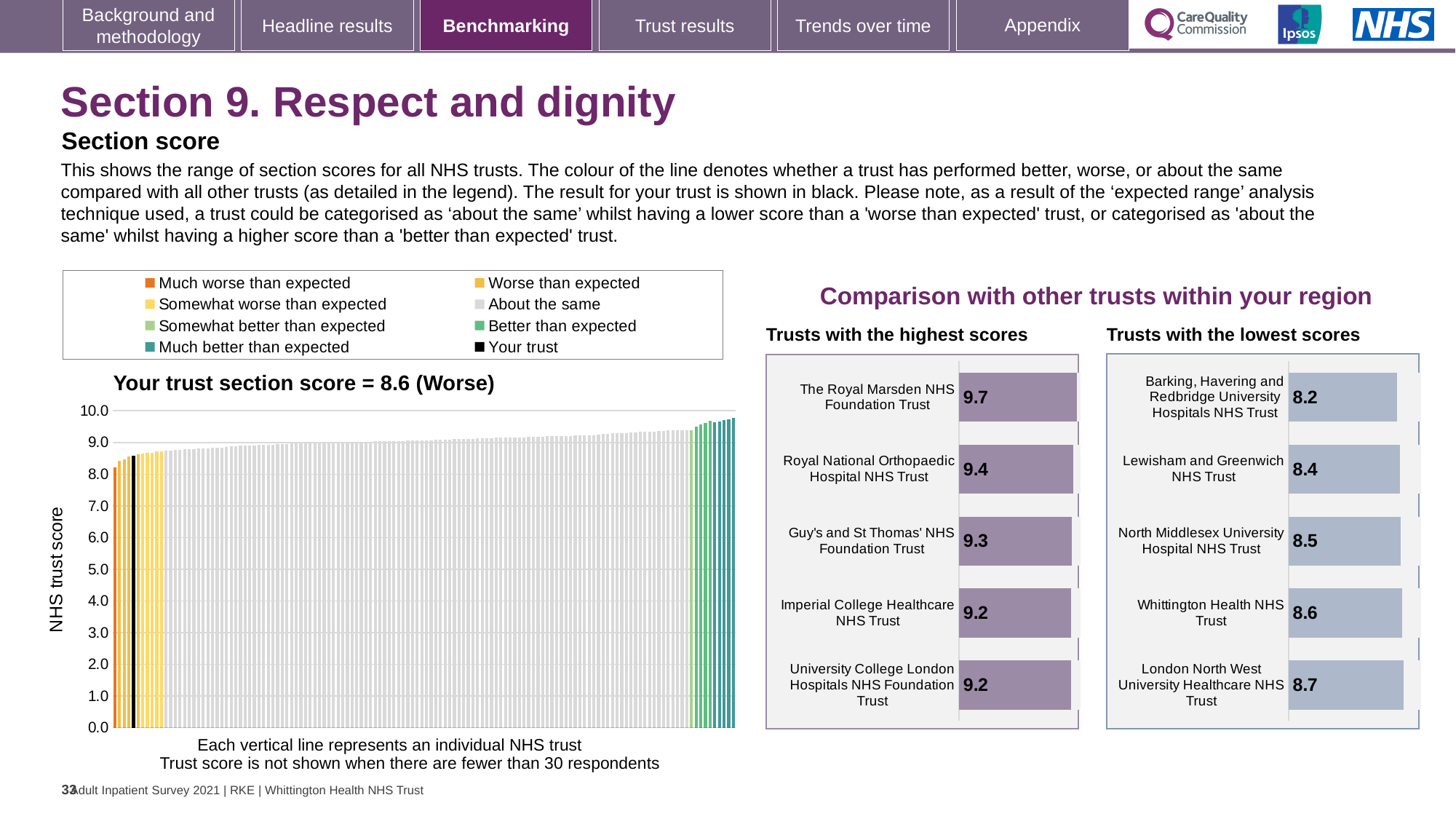
On the 'Trusts with the highest scores' chart, what is the score for Guy's and St Thomas' NHS Foundation Trust? 9.3 On the 'Trusts with the lowest scores' chart, which has the higher score: Lewisham and Greenwich NHS Trust or London North West University Healthcare NHS Trust? London North West University Healthcare NHS Trust On the 'Your trust section score' chart, do the bars rise or fall from left to right? rise On the 'Your trust section score' chart, is the value of the rightmost bar greater or less than 9.0? greater On the 'Trusts with the highest scores' chart, which trust has the highest score? The Royal Marsden NHS Foundation Trust On the 'Your trust section score' chart, what kind of chart is shown? bar chart On the 'Your trust section score' chart, what is the label of the vertical axis? NHS trust score On the 'Trusts with the lowest scores' chart, which trust has the lowest score? Barking, Havering and Redbridge University Hospitals NHS Trust On the 'Trusts with the lowest scores' chart, how many trusts are shown? 5 On the 'Trusts with the highest scores' chart, what is the difference between the scores of The Royal Marsden NHS Foundation Trust and Royal National Orthopaedic Hospital NHS Trust? 0.3 On the 'Your trust section score' chart, what is the section score for your trust? 8.6 On the 'Your trust section score' chart, how many entries does the legend list? 8